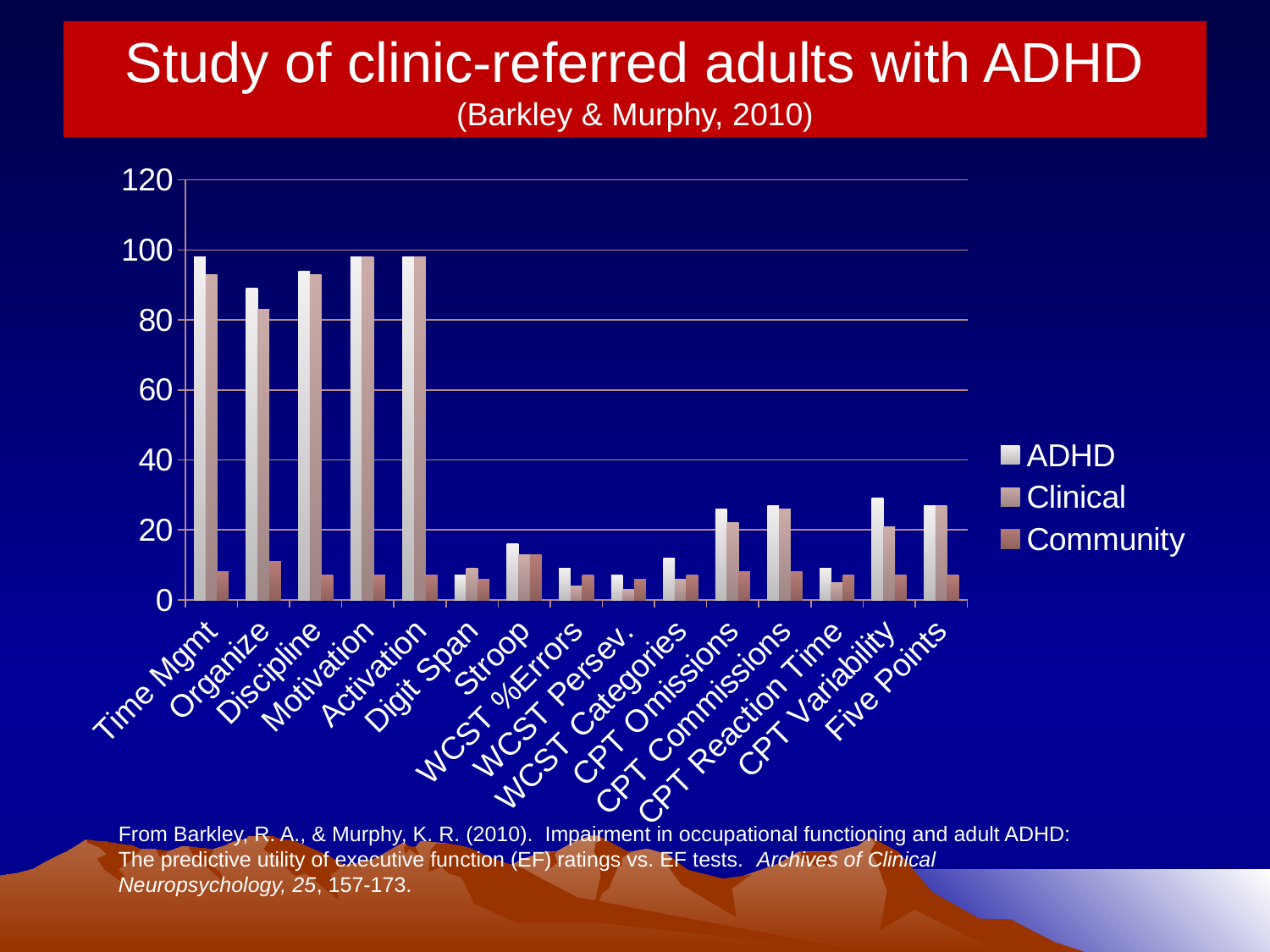
What is the title of the slide containing the chart? Study of clinic-referred adults with ADHD Is the ADHD value for CPT Variability greater or less than 20? greater Is the Clinical value for Organize greater or less than 60? greater Which is larger, the ADHD value for Time Mgmt or the ADHD value for Digit Span? Time Mgmt How many series does the legend list? 3 Is the ADHD value for Digit Span greater or less than 20? less How many categories are shown along the x axis? 15 What kind of chart is shown on the slide? bar chart Which series has the lowest value for Motivation? Community Which series has the highest value for Time Mgmt? ADHD